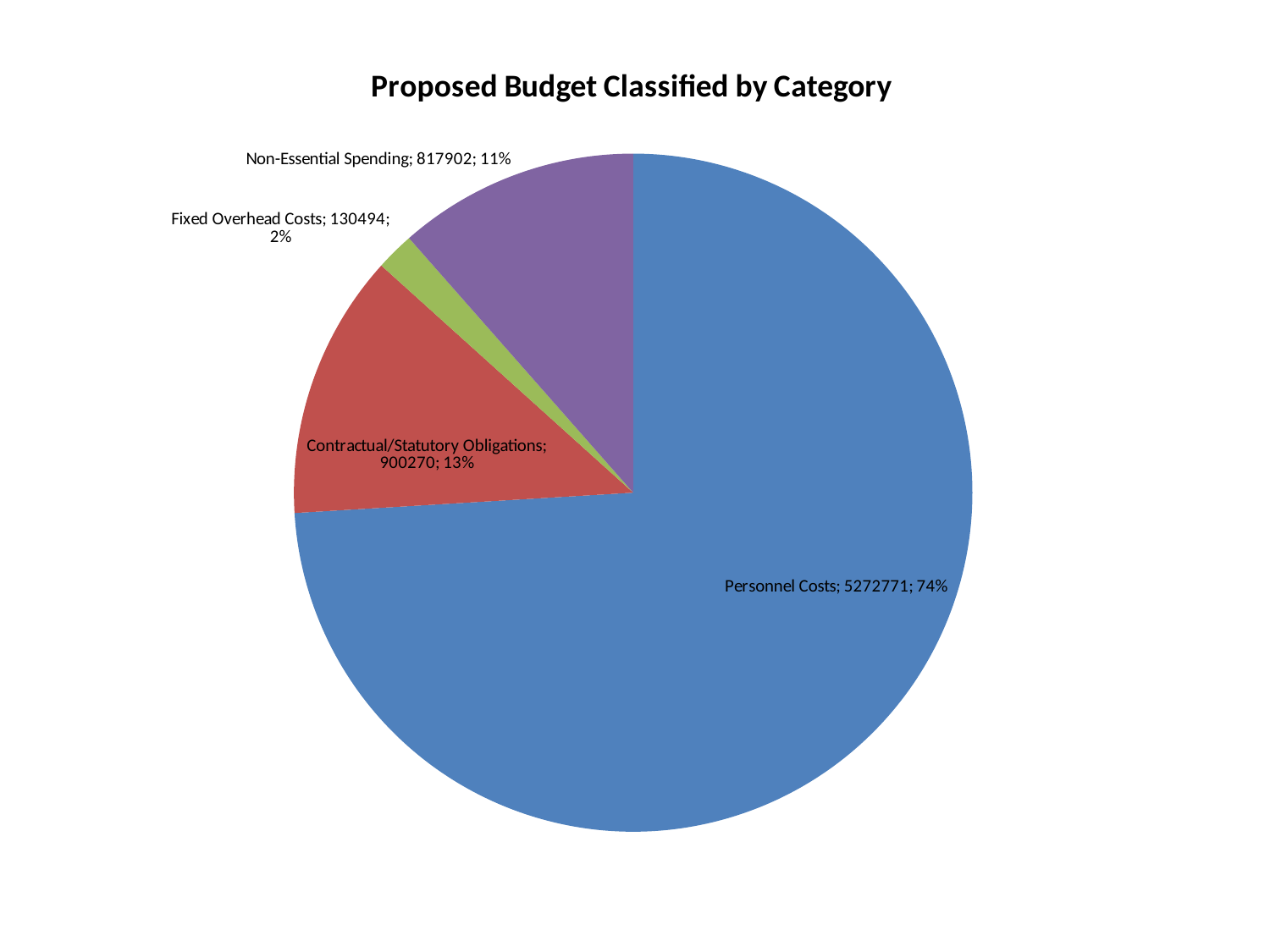
What is the value for Non-Essential Spending? 817902 What share of the pie does Personnel Costs represent? 74% How many categories are shown in the pie chart? 4 What is the value for Personnel Costs? 5272771 What is the value for Contractual/Statutory Obligations? 900270 What is the value for Fixed Overhead Costs? 130494 What type of chart is shown on the slide? pie chart Which category has the smallest slice? Fixed Overhead Costs What share of the pie does Non-Essential Spending represent? 11% What is the title of the chart? Proposed Budget Classified by Category Which category has the largest slice? Personnel Costs What is the difference between the values for Contractual/Statutory Obligations and Non-Essential Spending? 82368